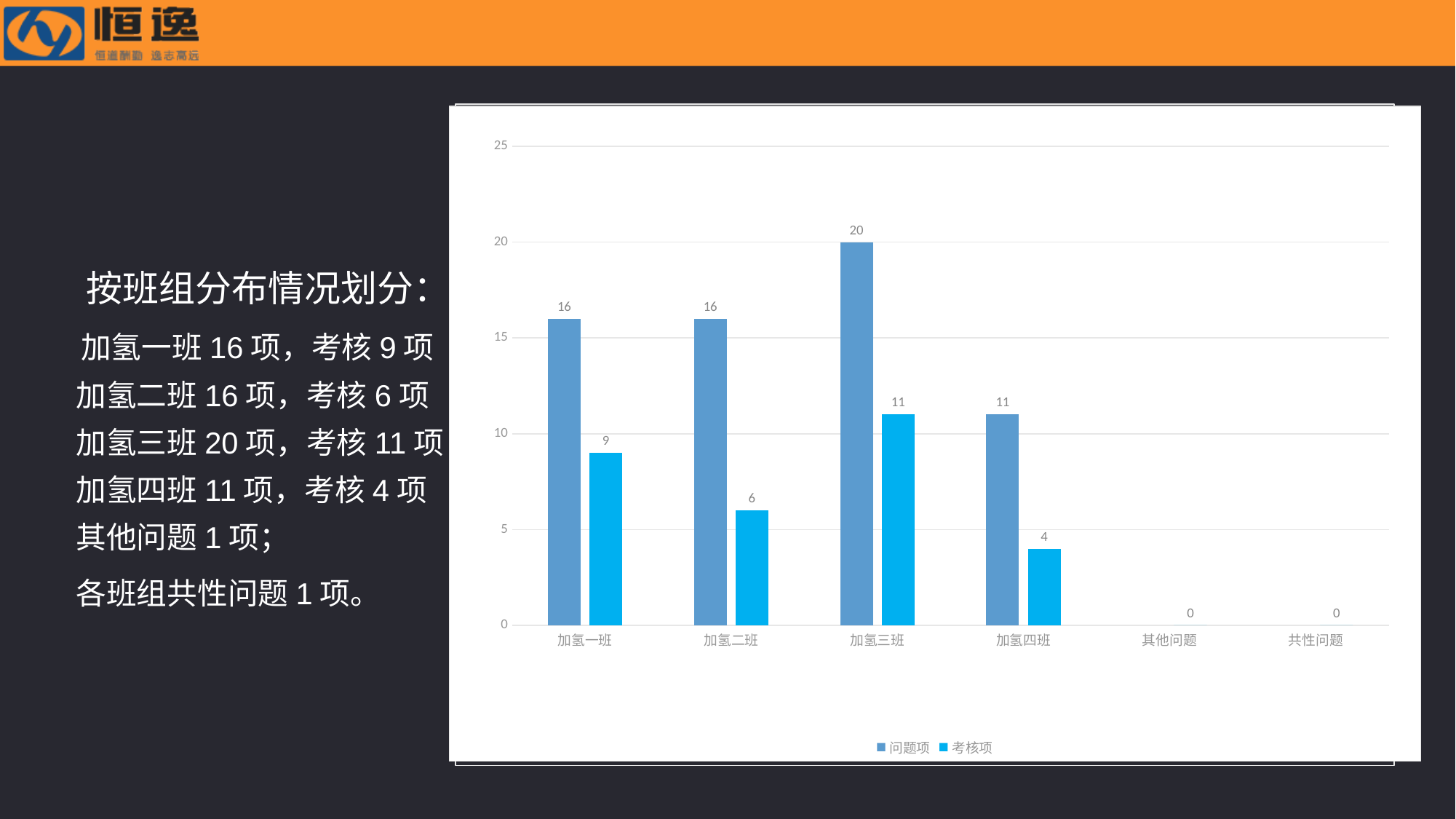
What is the 问题项 value for 加氢三班? 20 What kind of chart is shown on the slide? bar chart Which category has the highest 问题项 value? 加氢三班 How many categories are shown on the x axis of the chart? 6 How many series does the chart legend list? 2 What are the two series names listed in the chart legend? 问题项 and 考核项 What is the difference between the 问题项 and 考核项 values for 加氢二班? 10 Is the 问题项 value for 加氢四班 greater or less than 15? less Which is larger, the 考核项 value for 加氢三班 or the 考核项 value for 加氢一班? 加氢三班 Among the four 加氢 classes, which has the lowest 考核项 value? 加氢四班 What is the 考核项 value for 加氢四班? 4 What is the 考核项 value for 加氢一班? 9